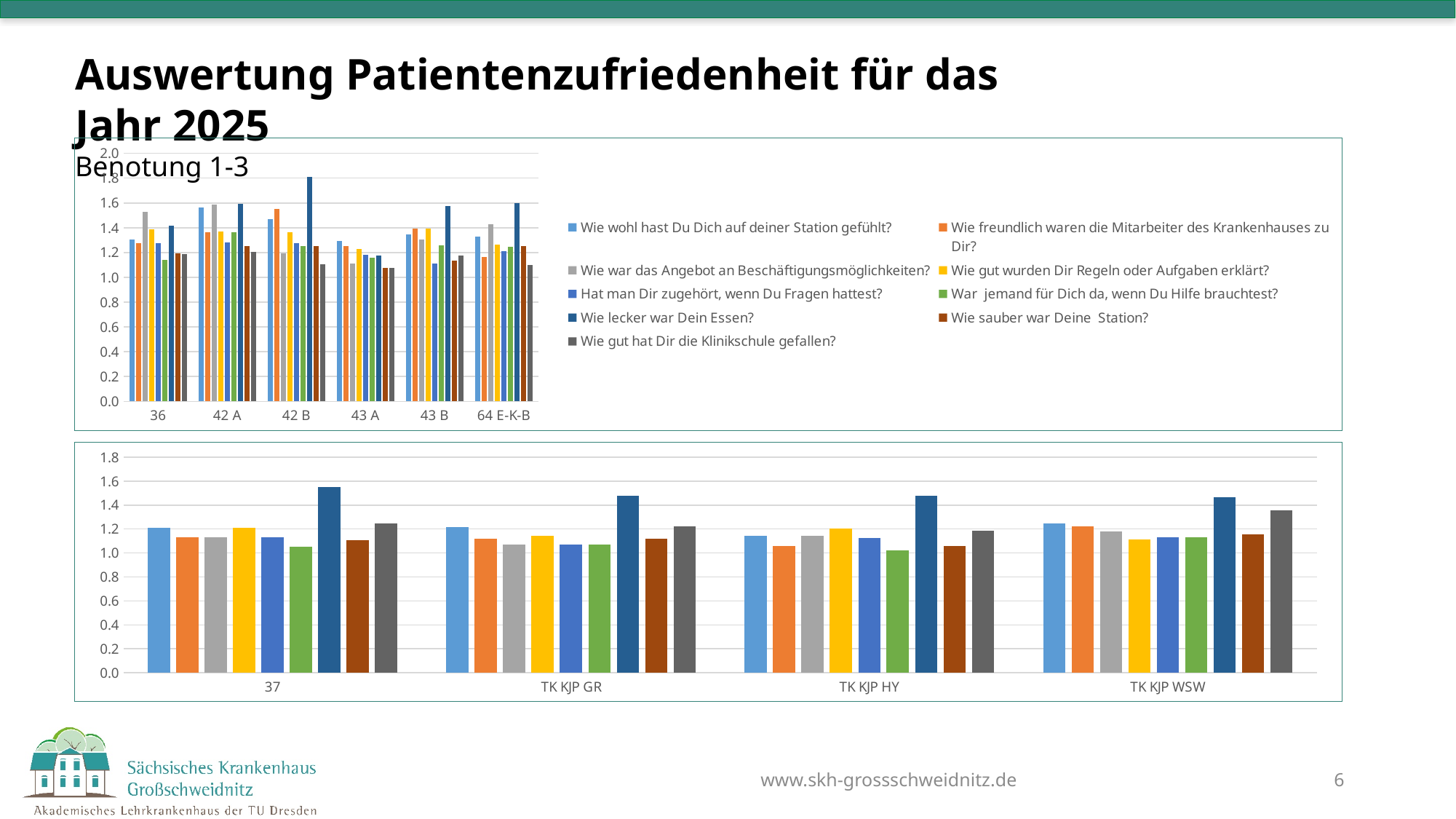
In the bottom chart, which category contains the tallest bar? 37 In the bottom chart, is the dark grey bar larger for 37 or for TK KJP WSW? TK KJP WSW What kind of chart is the bottom chart on the slide? bar chart In the bottom chart, is the tallest bar for 37 greater or less than 1.4? greater In the bottom chart, is the green bar for TK KJP HY greater or less than 1.2? less In the top chart's legend, which series is shown in dark blue? Wie lecker war Dein Essen? How many categories are shown on the x axis of the bottom chart? 4 How many categories are shown on the x axis of the top chart? 6 How many series does the legend of the top chart list? 9 What kind of chart is the top chart on the slide? bar chart In the top chart, which category contains the tallest bar? 42 B In the top chart, is the value of 'Wie lecker war Dein Essen?' for 42 B greater or less than 1.6? greater